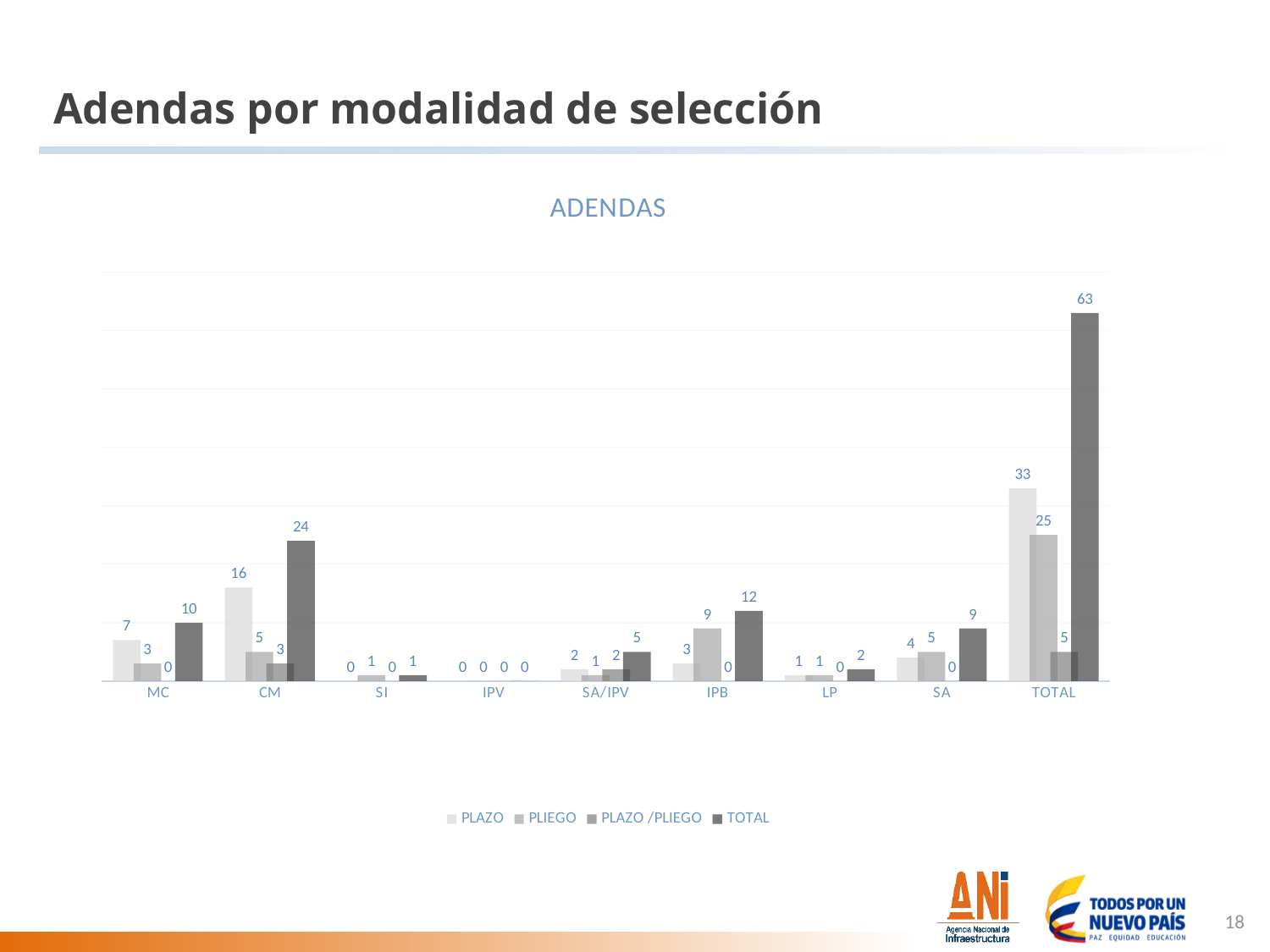
Which category has the lowest TOTAL value? IPV What is the difference between the PLAZO and PLIEGO values in the TOTAL category? 8 Which is larger, the PLAZO value for CM or the PLAZO value for IPB? PLAZO value for CM Excluding the TOTAL category, which category has the highest TOTAL value? CM How many series does the legend list? 4 What is the PLIEGO value for the IPB category? 9 What is the title of the chart? ADENDAS What is the TOTAL value for the CM category? 24 How many categories are shown on the x axis? 9 What is the TOTAL value for the TOTAL category? 63 What is the PLAZO value for the MC category? 7 What kind of chart is shown on the slide? Bar chart